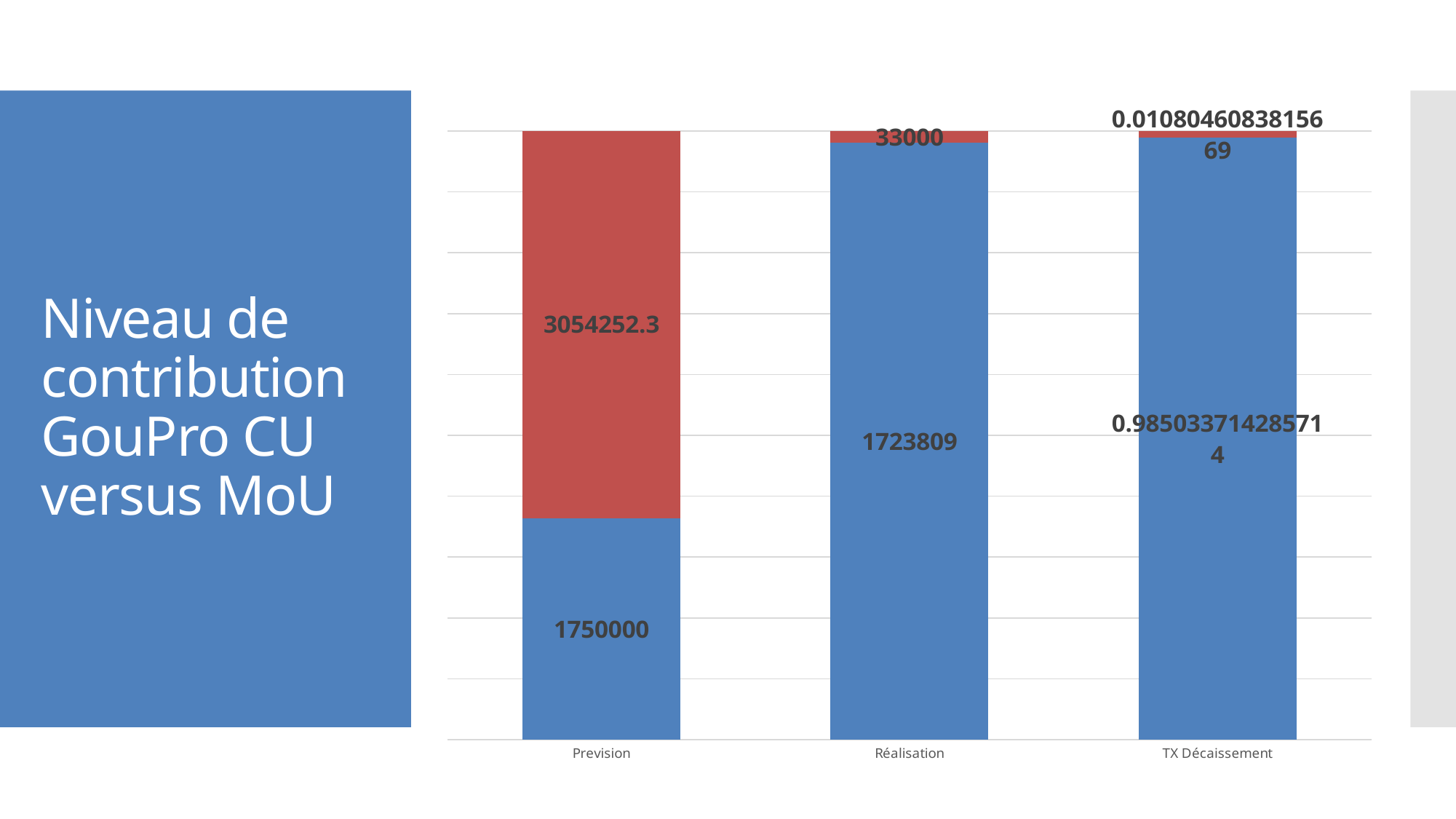
How many categories are shown on the x axis? 3 What is the value of the blue segment for Prevision? 1750000 What is the value of the blue segment for Réalisation? 1723809 What kind of chart is shown on the slide? Stacked bar chart What is the value of the red segment for Prevision? 3054252.3 What is the value of the red segment for TX Décaissement? 0.0108046083815669 What is the value of the red segment for Réalisation? 33000 What is the total of the two segments for Réalisation? 1756809 What is the title of the slide containing the chart? Niveau de contribution GouPro CU versus MoU For Prevision, which segment has the larger value, the blue or the red? Red What is the difference between the red and blue segment values for Prevision? 1304252.3 What is the value of the blue segment for TX Décaissement? 0.985033714285714